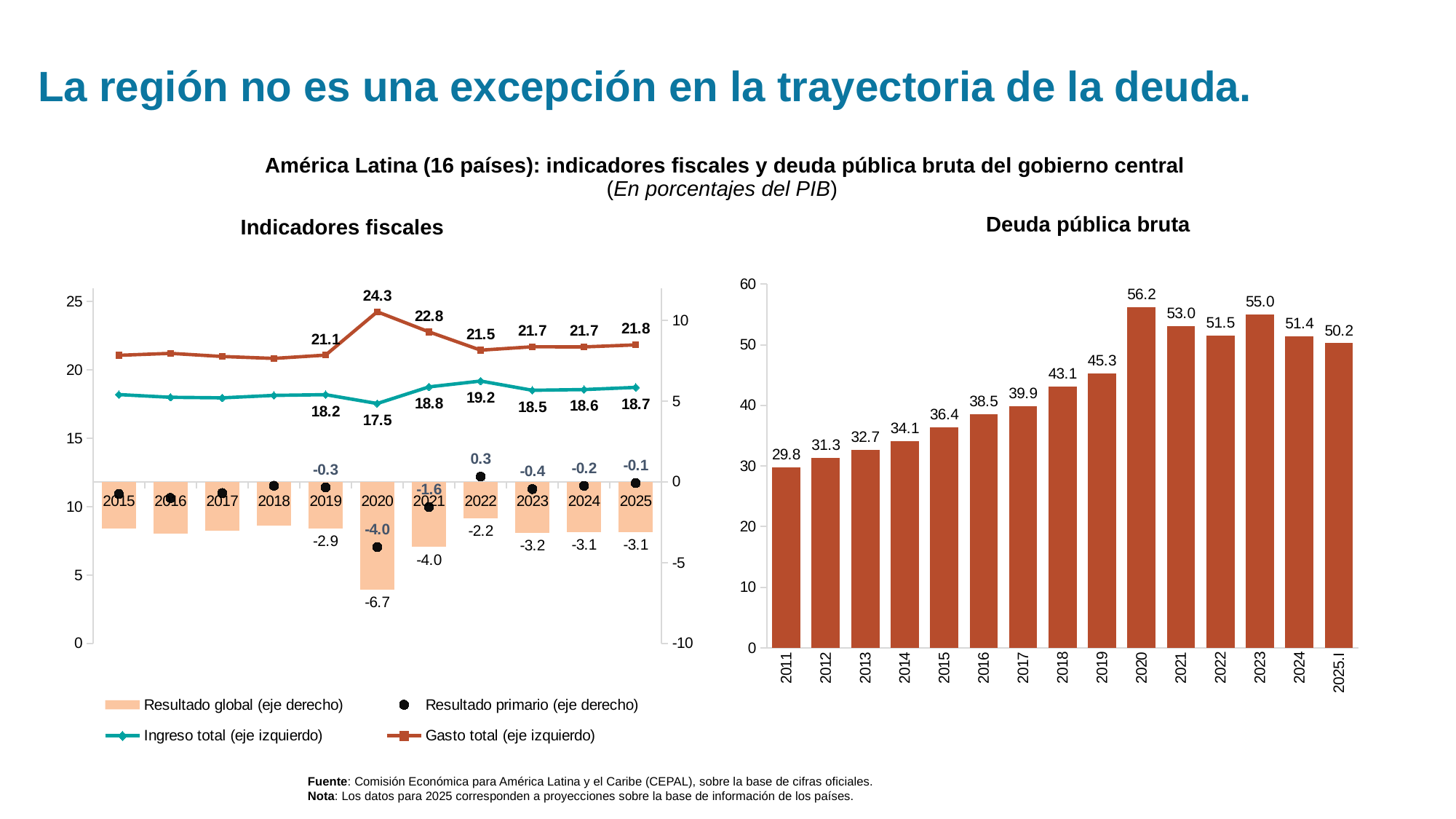
In the 'Deuda pública bruta' chart, which year has the highest value? 2020 In the 'Indicadores fiscales' chart, what is the difference between Gasto total and Ingreso total in 2025? 3.1 What kind of chart is the 'Deuda pública bruta' chart? bar chart How many series does the legend of the 'Indicadores fiscales' chart list? 4 In the 'Deuda pública bruta' chart, which year has the lowest value? 2011 In the 'Deuda pública bruta' chart, how many bars are plotted? 15 In the 'Indicadores fiscales' chart, what is the value of Resultado global for 2020? -6.7 In the 'Deuda pública bruta' chart, what is the difference between the values for 2020 and 2011? 26.4 In the 'Indicadores fiscales' chart, what is the value of Gasto total for 2020? 24.3 In the 'Deuda pública bruta' chart, what is the value for 2020? 56.2 In the 'Deuda pública bruta' chart, is the value for 2023 larger or smaller than the value for 2024? larger In the 'Indicadores fiscales' chart, what is the value of Resultado primario for 2022? 0.3